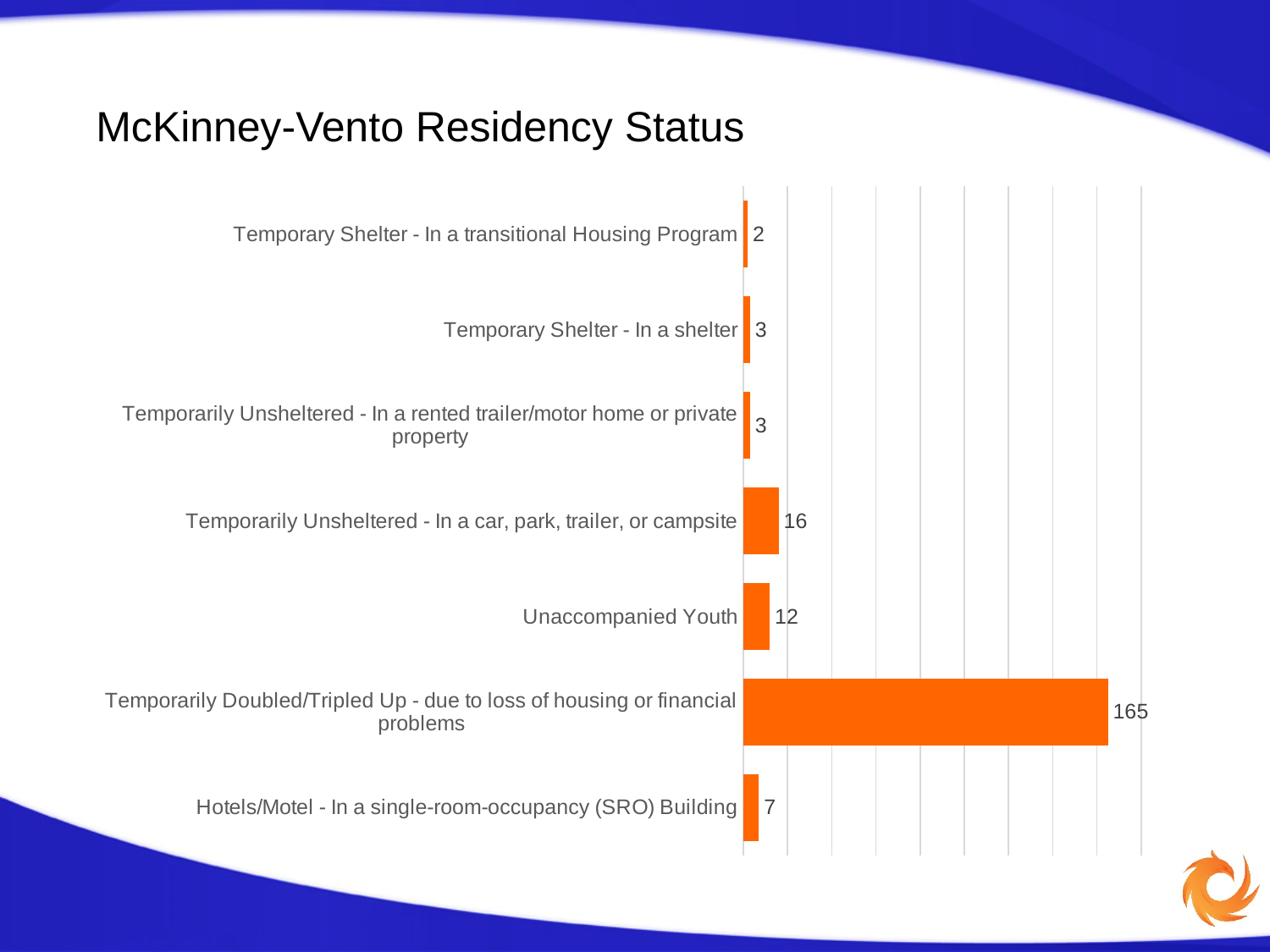
Which is larger, the value for Unaccompanied Youth or the value for Hotels/Motel - In a single-room-occupancy (SRO) Building? Unaccompanied Youth What is the value for Temporarily Unsheltered - In a car, park, trailer, or campsite? 16 How many categories are shown in the chart? 7 Which category has the lowest value? Temporary Shelter - In a transitional Housing Program What kind of chart is shown on the slide? Bar chart Which category has the highest value? Temporarily Doubled/Tripled Up - due to loss of housing or financial problems What is the value for Unaccompanied Youth? 12 What is the value for Hotels/Motel - In a single-room-occupancy (SRO) Building? 7 What is the difference between the values for Temporarily Doubled/Tripled Up and Temporarily Unsheltered - In a car, park, trailer, or campsite? 149 What is the title of the slide? McKinney-Vento Residency Status What is the value for Temporarily Doubled/Tripled Up - due to loss of housing or financial problems? 165 What is the value for Temporary Shelter - In a transitional Housing Program? 2